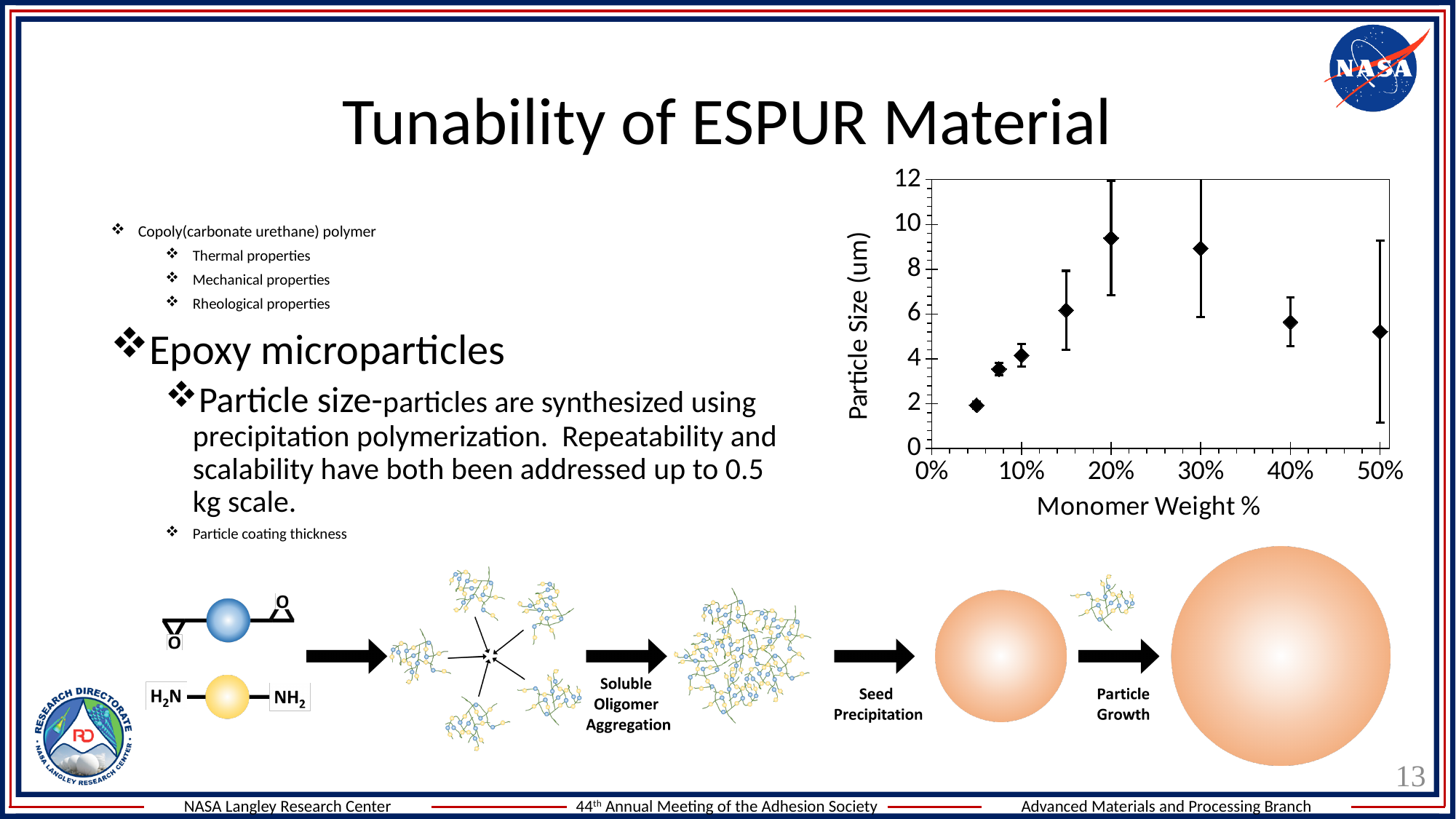
What is the label of the x axis of the chart? Monomer Weight % What kind of chart is shown on the slide? Scatter plot with error bars Is the particle size at 30% monomer weight greater or less than 8 um? greater Does particle size rise or fall as monomer weight increases from 0% to 20%? rise Is the particle size of the leftmost data point greater or less than 4 um? less Is the particle size at 20% monomer weight greater or less than 8 um? greater How many data points are plotted in the Particle Size chart? 8 What is the label of the y axis of the chart? Particle Size (um) Which has the larger particle size, 20% or 40% monomer weight? 20% Which has the larger particle size, 30% or 50% monomer weight? 30%